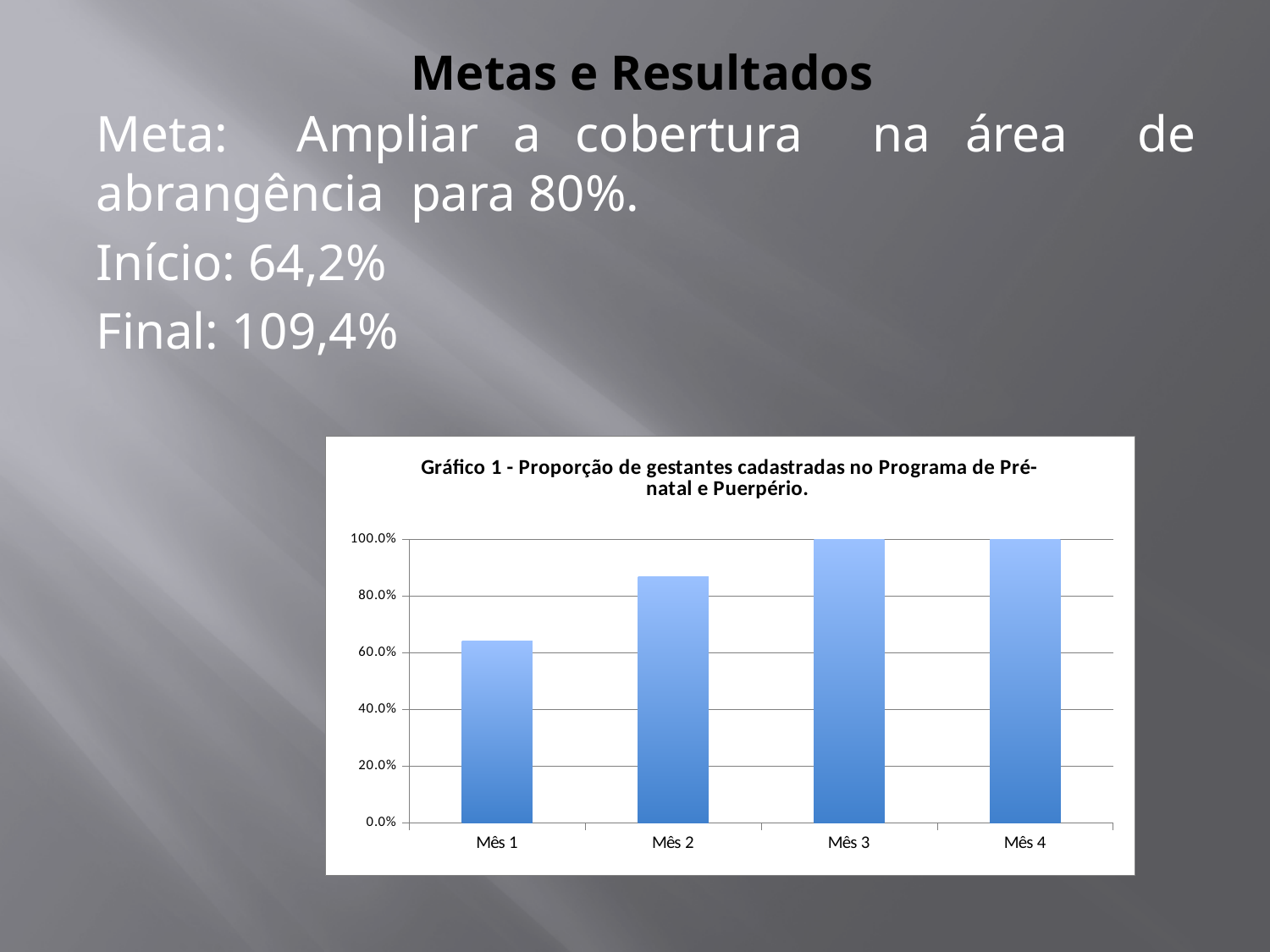
Do the values generally rise or fall from Mês 1 to Mês 4? rise What is the highest value shown on the chart's vertical axis? 100.0% Is the value for Mês 1 greater or less than 80.0%? less What is the title of the chart? Gráfico 1 - Proporção de gestantes cadastradas no Programa de Pré-natal e Puerpério. Is the value for Mês 2 greater or less than 80.0%? greater Is the value for Mês 2 greater or less than 100.0%? less Which is larger, the value for Mês 1 or the value for Mês 2? Mês 2 How many categories (months) are shown on the x axis of the chart? 4 Which is larger, the value for Mês 2 or the value for Mês 3? Mês 3 Which month has the lowest value in the chart? Mês 1 What kind of chart is shown on the slide? bar chart